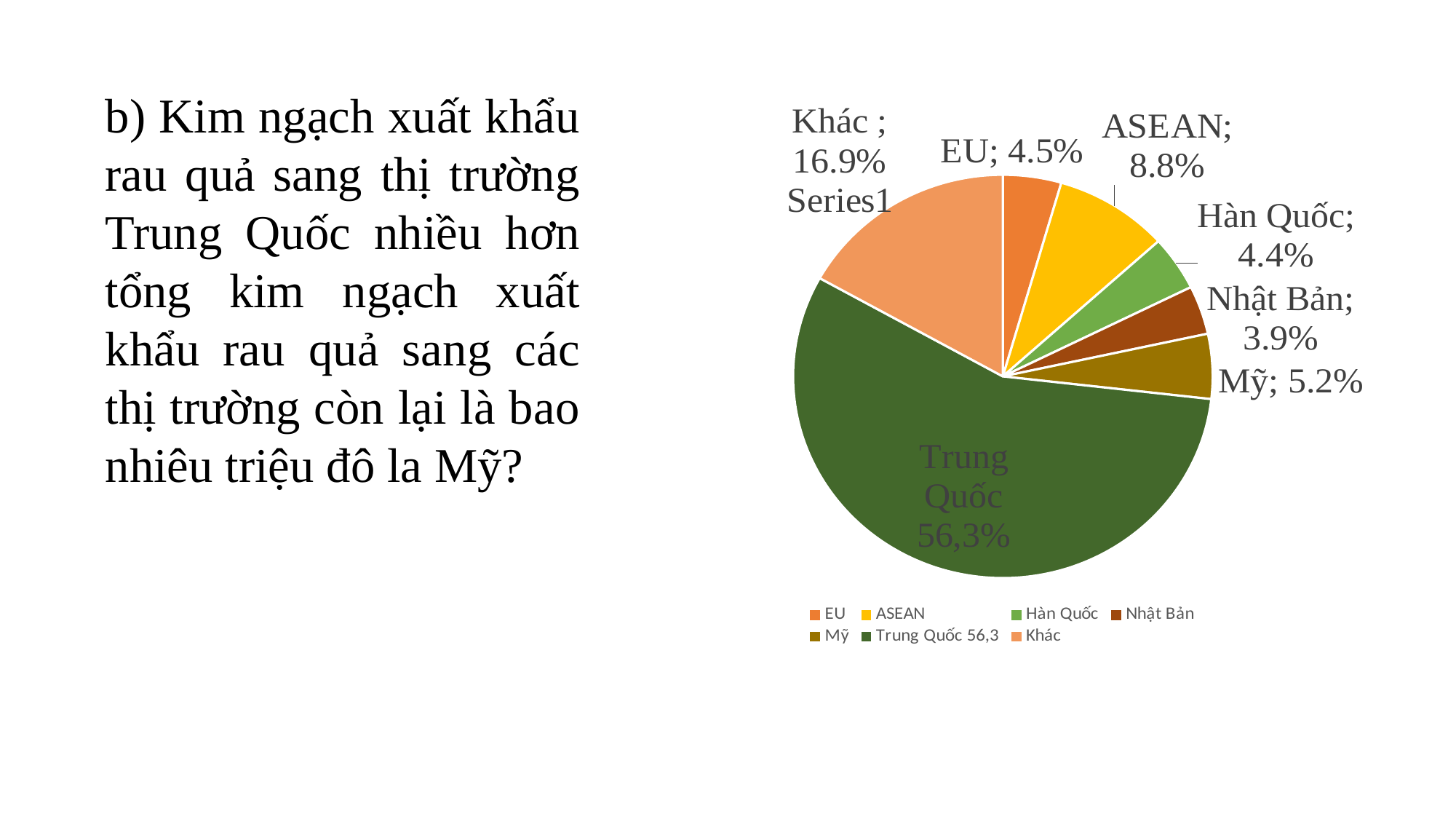
What is the value shown for ASEAN? 8.8% What is the value shown for Khác? 16.9% What is the value shown for Nhật Bản? 3.9% How many slices does the pie chart have? 7 What colour is the Trung Quốc slice in the pie chart? dark green What is the difference between the ASEAN value and the EU value? 4.3% What is the value shown for Mỹ? 5.2% Which category has the largest slice of the pie? Trung Quốc What share of the pie does Trung Quốc hold? 56,3% Which category has the smallest slice of the pie? Nhật Bản What kind of chart is shown on the slide? pie chart Which is larger, the slice for Khác or the slice for ASEAN? Khác